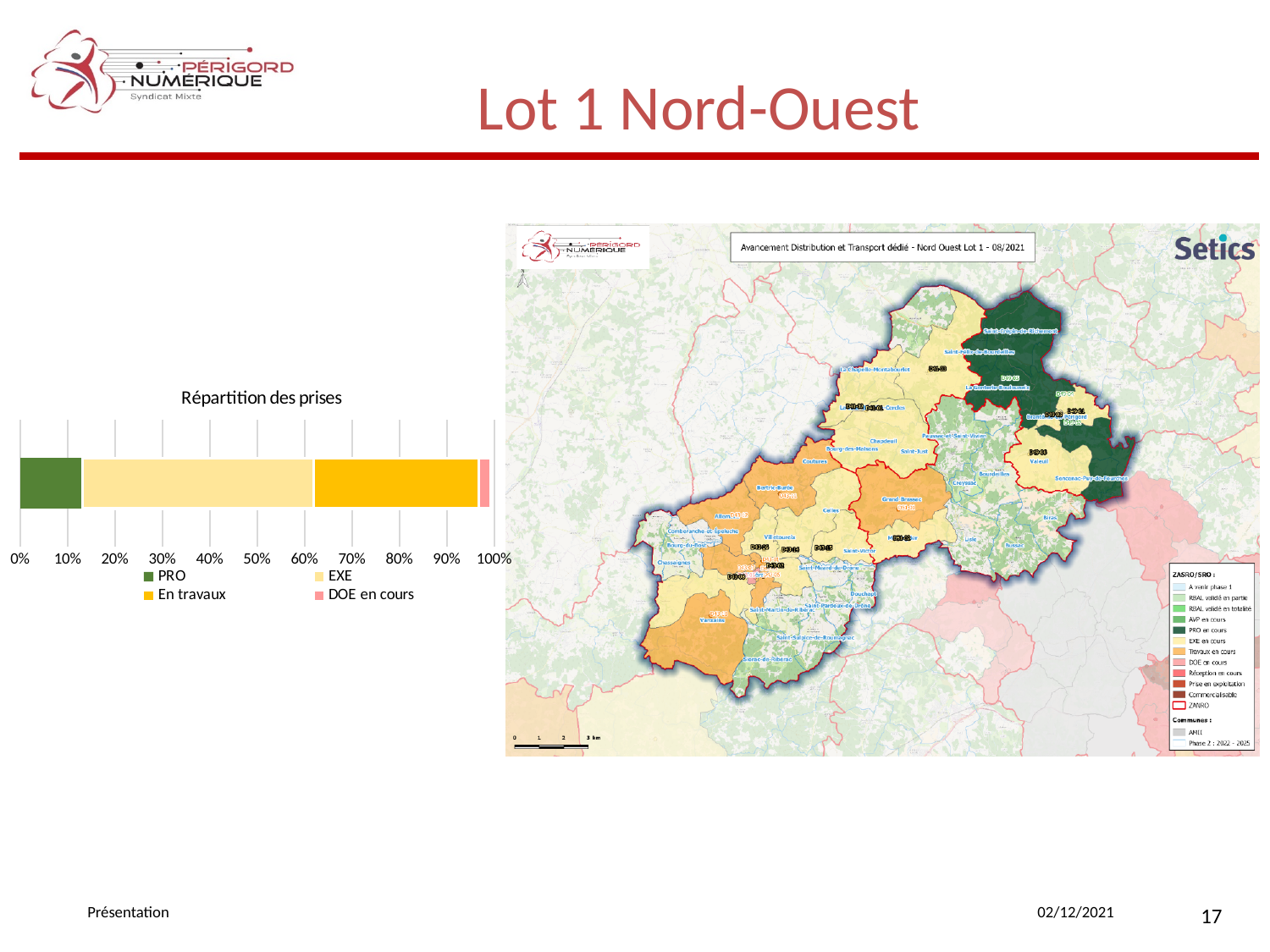
How many series does the legend of the "Répartition des prises" chart list? 4 What is the title of the chart on the left of the slide? Répartition des prises In the "Répartition des prises" chart, is the value for DOE en cours greater or less than 10%? less In the "Répartition des prises" chart, which segment is larger, En travaux or DOE en cours? En travaux In the "Répartition des prises" chart, is the value for PRO greater or less than 20%? less In the "Répartition des prises" chart, which series has the smallest share of the bar? DOE en cours In the "Répartition des prises" chart, which segment is larger, EXE or PRO? EXE What kind of chart is "Répartition des prises"? Stacked bar chart In the "Répartition des prises" chart, is the value for EXE greater or less than 40%? greater Which series are listed in the legend of the "Répartition des prises" chart? PRO, EXE, En travaux, DOE en cours In the "Répartition des prises" chart, which series has the largest share of the bar? EXE